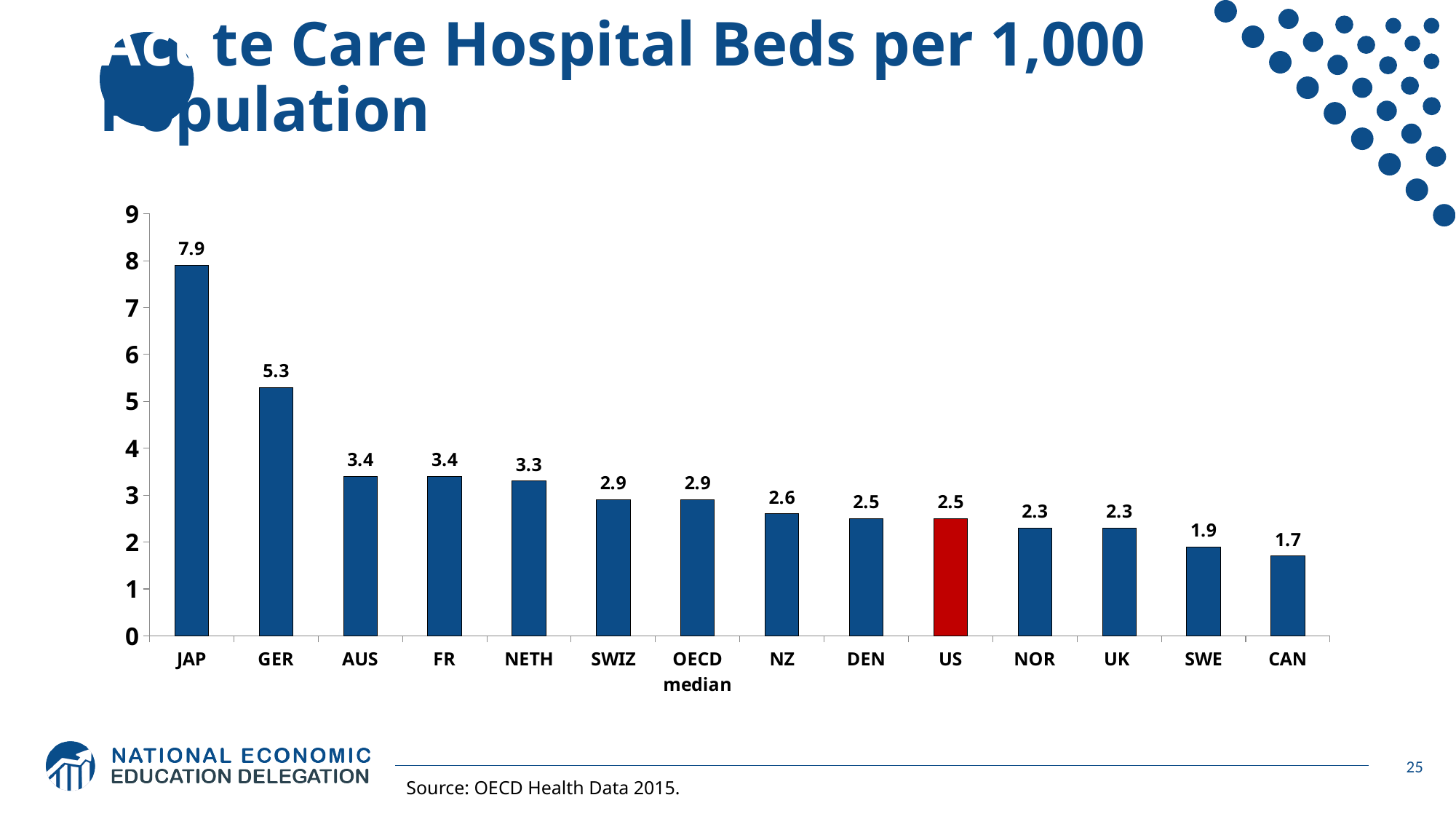
What is the value for the US? 2.5 Which category has the lowest value? CAN What is the value for JAP? 7.9 What is the difference between the values for JAP and GER? 2.6 What kind of chart is shown on the slide? bar chart Is the value for GER greater or less than 5? greater What is the value for the OECD median? 2.9 Which is larger, the value for NETH or the value for SWIZ? NETH Which category has the highest value? JAP Which bar is coloured red rather than blue? US What is the difference between the OECD median and the US value? 0.4 How many categories are shown on the x axis? 14